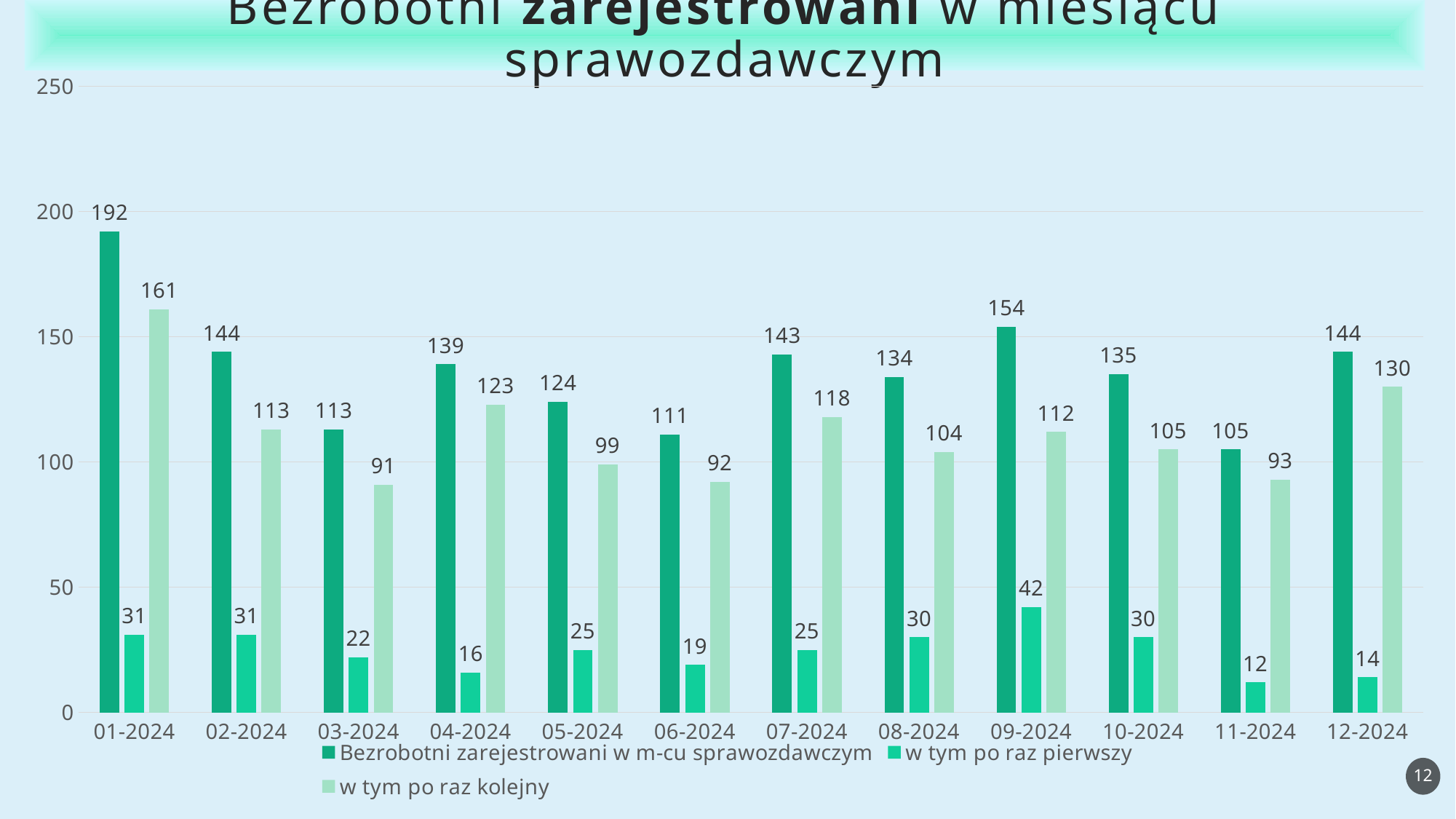
What is the difference between 'Bezrobotni zarejestrowani w m-cu sprawozdawczym' for 09-2024 and 11-2024? 49 How many months are shown on the x axis? 12 How many series does the legend list? 3 Which month has the highest value for 'Bezrobotni zarejestrowani w m-cu sprawozdawczym'? 01-2024 What is the value of 'w tym po raz pierwszy' for 09-2024? 42 Is the value of 'Bezrobotni zarejestrowani w m-cu sprawozdawczym' for 06-2024 greater or less than 100? greater What is the value of 'Bezrobotni zarejestrowani w m-cu sprawozdawczym' for 01-2024? 192 Which month has the lowest value for 'w tym po raz pierwszy'? 11-2024 Which is larger: 'w tym po raz kolejny' for 04-2024 or for 07-2024? 04-2024 What is the value of 'w tym po raz kolejny' for 03-2024? 91 What is the value of 'w tym po raz kolejny' for 12-2024? 130 What kind of chart is shown on the slide? bar chart